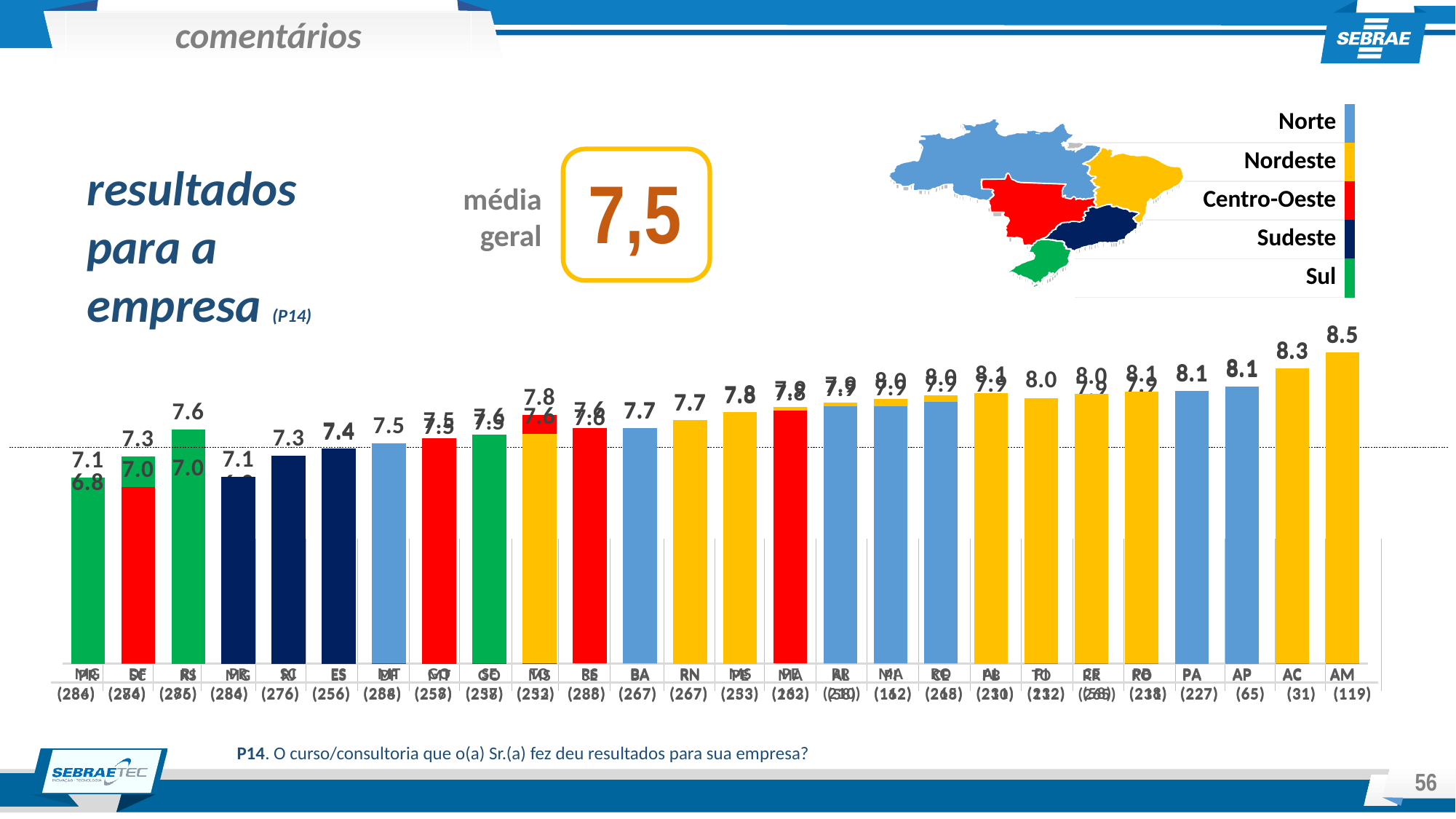
What is the difference between the values for AM and AC? 0.2 What is the value shown for ES? 7.4 What kind of chart is shown on the slide? bar chart Which has the larger value, PA or BA? PA How many regions does the legend list? 5 Which state has the highest value in the chart? AM Do the bar values generally rise or fall from left to right? rise What is the value shown for AC? 8.3 What number appears in parentheses under the AM label? 119 What is the value shown for BA? 7.7 What is the 'média geral' value shown on the slide? 7,5 What is the value shown for AM? 8.5